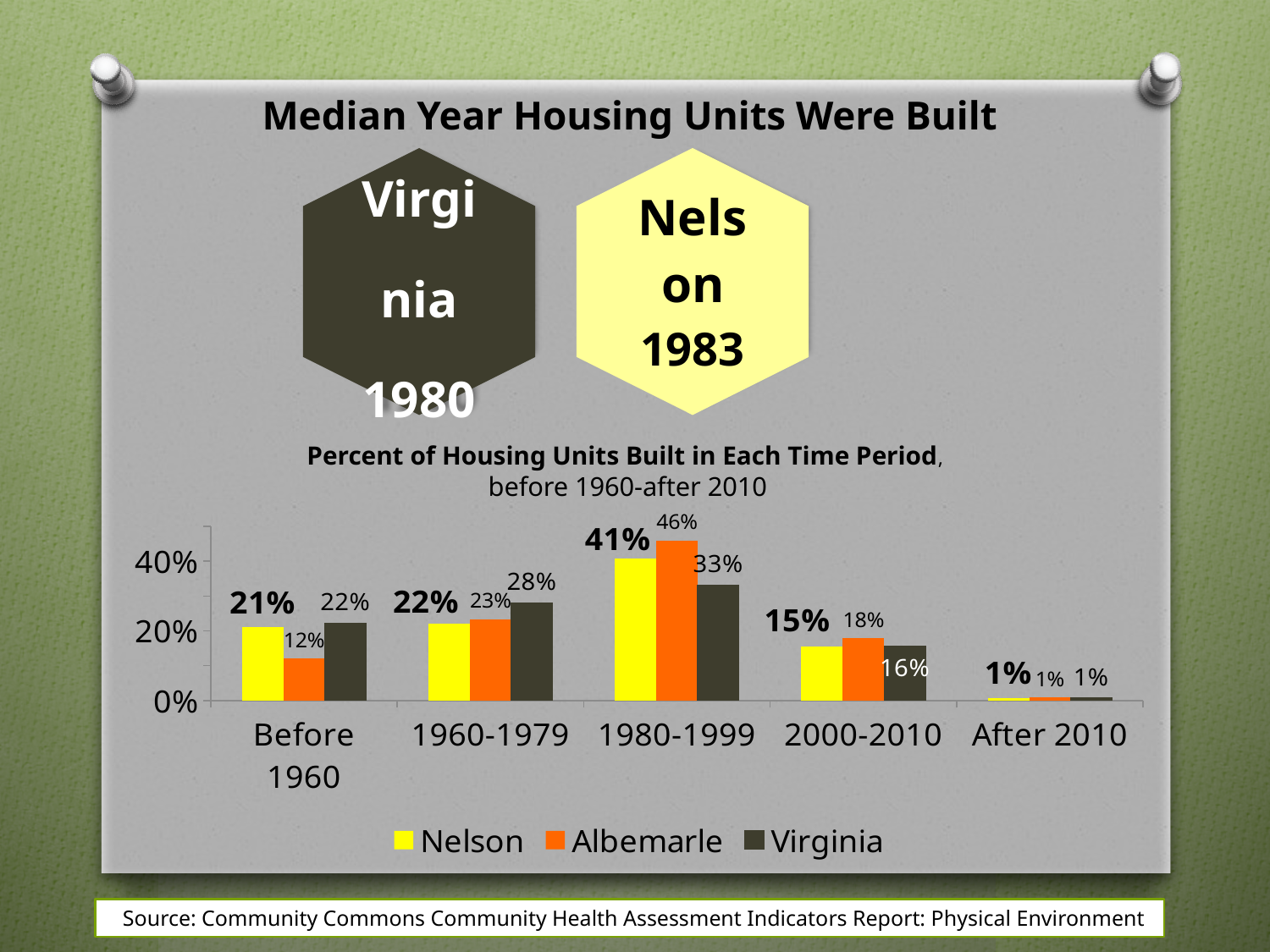
What is the value for Virginia in the 1960-1979 period? 28% How many time periods are shown on the x axis? 5 In the Before 1960 period, which is larger: the value for Nelson or the value for Albemarle? Nelson What is the value for Albemarle in the Before 1960 period? 12% How many series does the legend list? 3 In which time period does Nelson have its lowest value? After 2010 What is the value for Albemarle in the 2000-2010 period? 18% Is the value for Albemarle in 1980-1999 greater or less than 40%? greater In which time period does Albemarle have its highest value? 1980-1999 What percent of Nelson's housing units were built in 1980-1999? 41% What kind of chart is shown on the slide? bar chart What is the difference between Albemarle's and Virginia's values in the 1980-1999 period? 13%